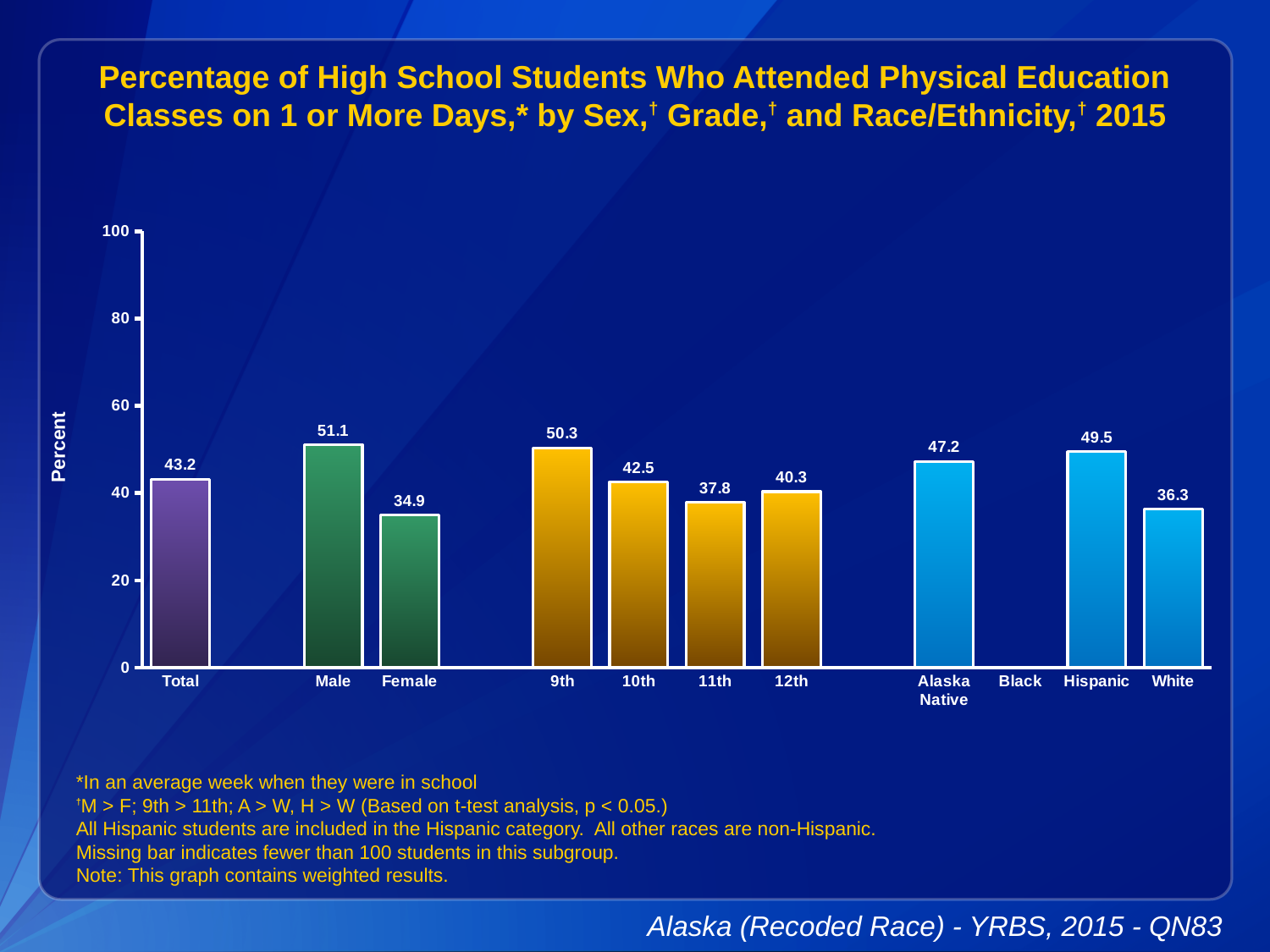
What is the difference between the values for Male and Female? 16.2 How many bars are plotted on the chart? 10 What is the value for Female? 34.9 What is the value for 11th grade? 37.8 What is the value for Male? 51.1 Is the value for Hispanic greater or less than 40? greater Which is larger, the value for 9th grade or 12th grade? 9th Which category has the lowest value? Female Which category has the highest value? Male What is the value for Alaska Native? 47.2 Which category has no bar shown? Black What kind of chart is shown? bar chart